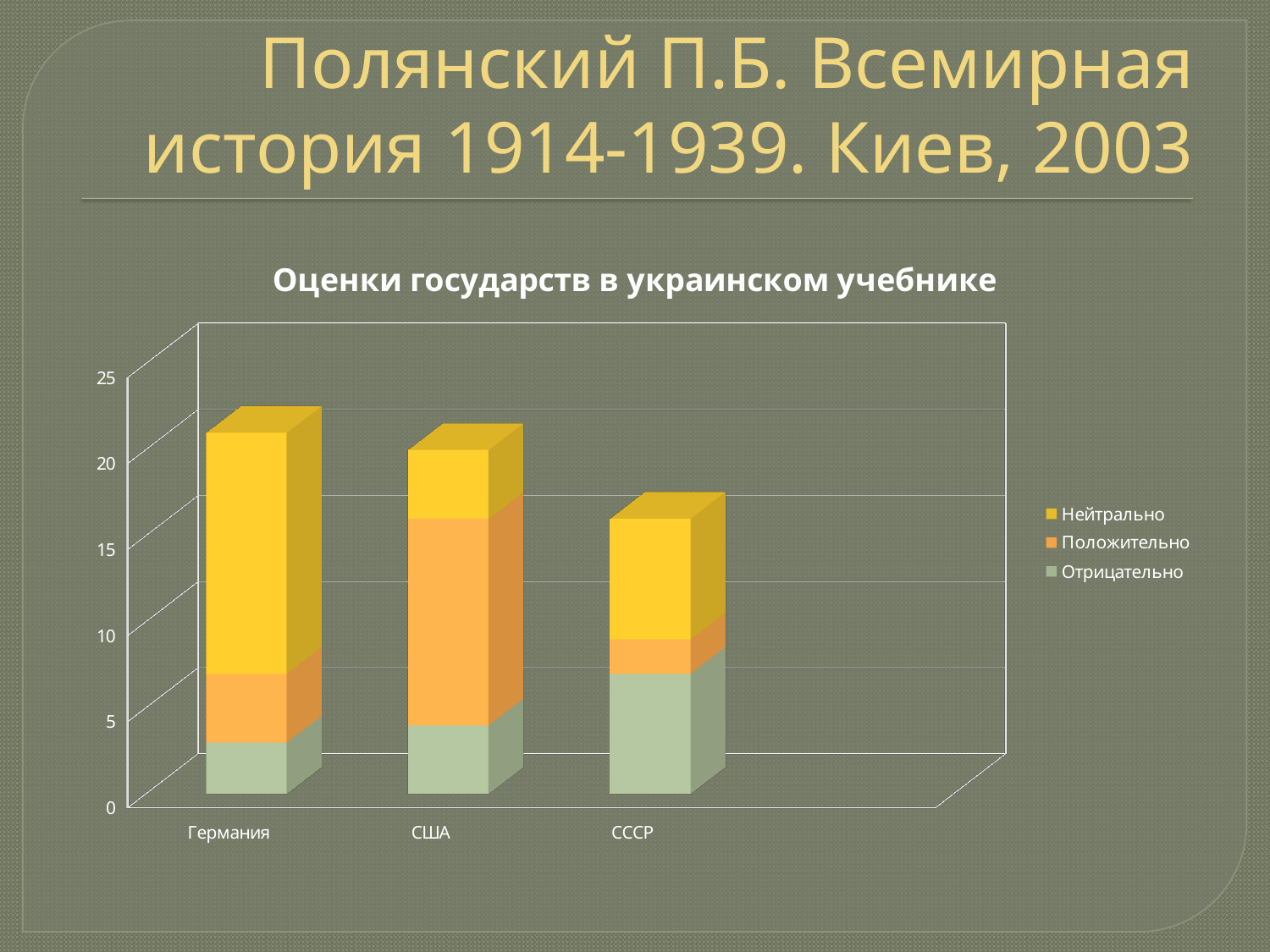
What is the title of the chart? Оценки государств в украинском учебнике Which country has the lowest total bar in the chart? СССР Which country has the largest Нейтрально segment? Германия Which country has the largest Положительно segment? США Is the total bar for Германия greater or less than 15? greater Which is larger: the Положительно segment for США or the Положительно segment for СССР? США What kind of chart is shown on the slide? stacked bar chart How many countries (categories) are shown on the x axis of the chart? 3 Is the total bar for СССР greater or less than 20? less How many series does the legend of the chart list? 3 Which country has the largest Отрицательно segment? СССР Which series is shown in the lightest green colour at the bottom of each bar? Отрицательно